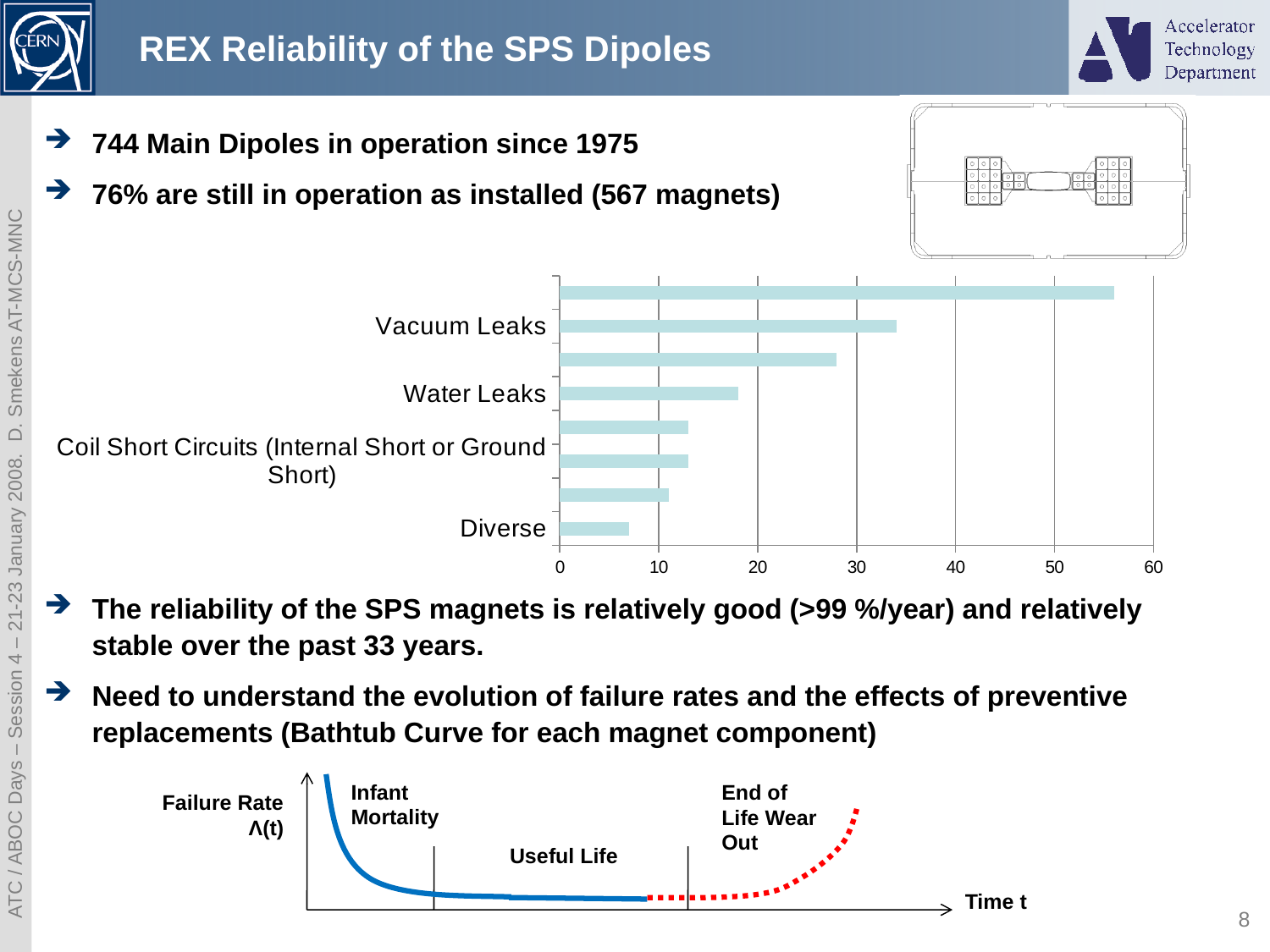
Which labeled category in the bar chart has the lowest value? Diverse Is the value for Vacuum Leaks greater or less than 40? less Which is larger in the bar chart, Water Leaks or Coil Short Circuits (Internal Short or Ground Short)? Water Leaks How many bars are plotted in the bar chart? 8 Which is larger in the bar chart, Vacuum Leaks or Water Leaks? Vacuum Leaks What kind of chart is shown in the middle of the slide? bar chart What are the three phases labeled on the bathtub curve at the bottom of the slide? Infant Mortality, Useful Life, End of Life Wear Out Is the value for Water Leaks greater or less than 20? less Is the value for Diverse greater or less than 10? less What is the maximum value shown on the horizontal axis of the bar chart? 60